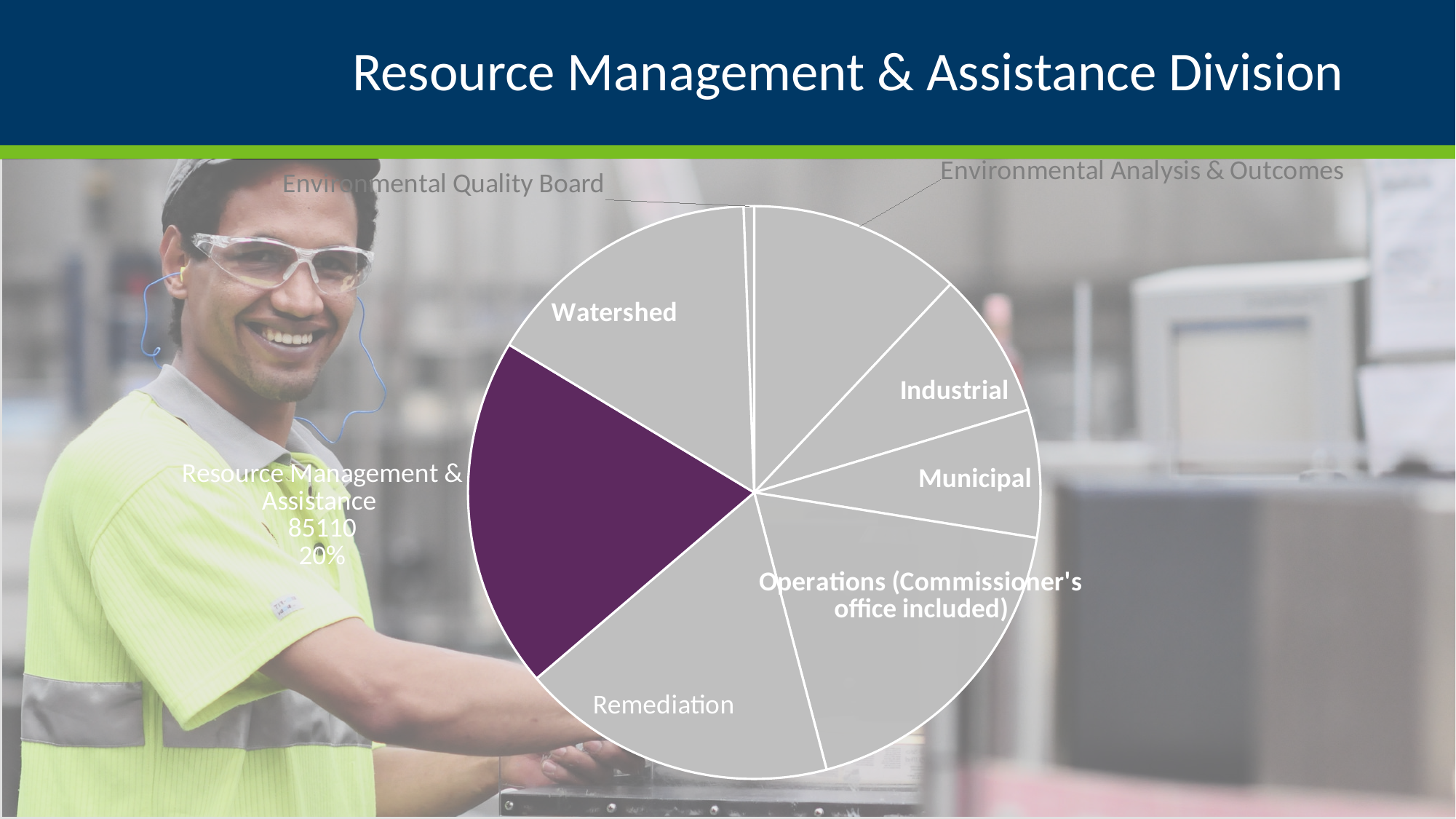
Which slice is larger, Environmental Quality Board or Industrial? Industrial Which slice is larger, Municipal or Resource Management & Assistance? Resource Management & Assistance How many slices does the pie chart have? 8 What share of the pie does the Resource Management & Assistance slice represent? 20% What value is shown for the Resource Management & Assistance slice? 85110 Which slice is larger, Environmental Quality Board or Watershed? Watershed What is the title of the slide containing the pie chart? Resource Management & Assistance Division Which slice of the pie chart is highlighted in purple? Resource Management & Assistance Which slice of the pie chart is the smallest? Environmental Quality Board What kind of chart is shown on the slide? pie chart